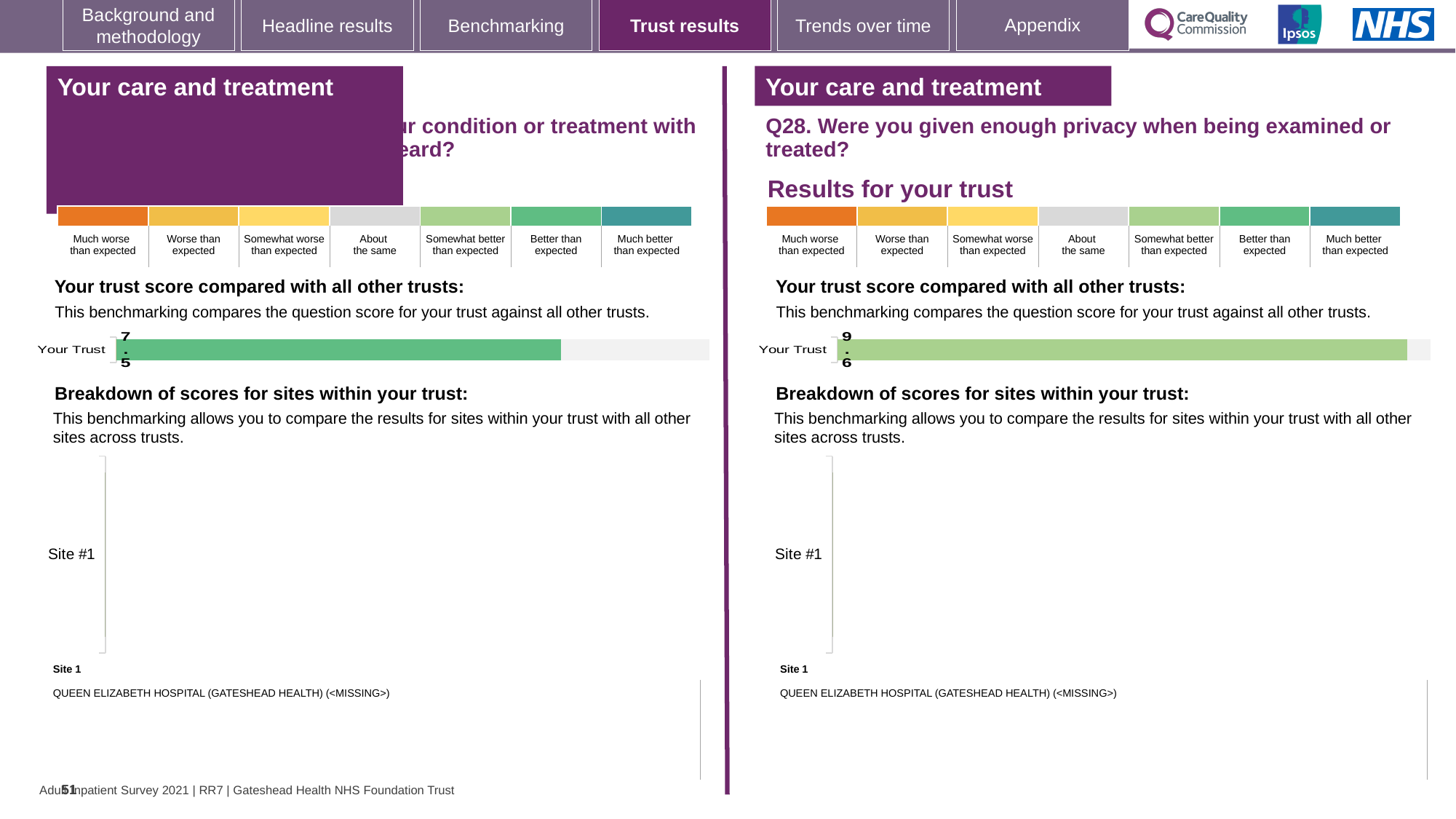
On the Q28 chart, which benchmark category does the colour of the Your Trust bar correspond to? Somewhat better than expected Which trust score is larger: the left chart's Your Trust score or the Q28 chart's Your Trust score? Q28 chart (9.6) On the left chart, which benchmark category does the colour of the Your Trust bar correspond to? Better than expected On the Q28 chart on the right, what is the score shown for Your Trust? 9.6 How many sites are listed in the breakdown of scores for sites on the Q28 panel? 1 How many categories are plotted in the Your Trust score chart on the left panel? 1 What is the difference between the Q28 Your Trust score (9.6) and the left chart's Your Trust score (7.5)? 2.1 On the left chart, what is the score shown for Your Trust? 7.5 What is the label of the single category in the Q28 trust score chart? Your Trust What kind of chart is used to show the Your Trust score on the Q28 panel? Bar chart